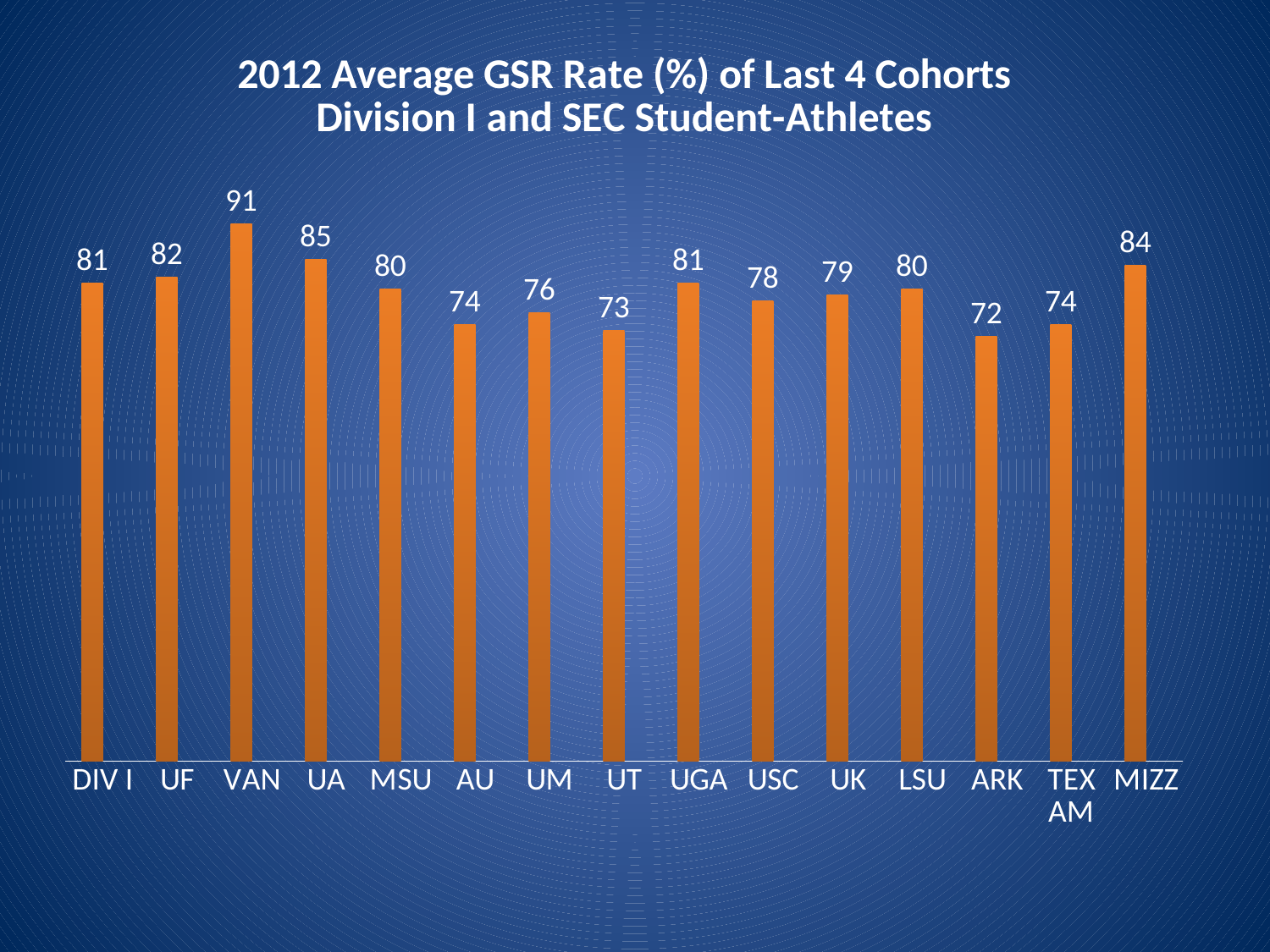
What is the value for VAN? 91 What is the difference between the values for VAN and ARK? 19 Which is larger, the value for UF or the value for UGA? UF What kind of chart is this? Bar chart What is the difference between the values for UA and MSU? 5 What is the value for TEX AM? 74 What is the value for DIV I? 81 What is the value for ARK? 72 What is the title of the chart? 2012 Average GSR Rate (%) of Last 4 Cohorts Division I and SEC Student-Athletes Which category has the lowest value? ARK How many categories are shown on the x axis? 15 Which category has the highest value? VAN